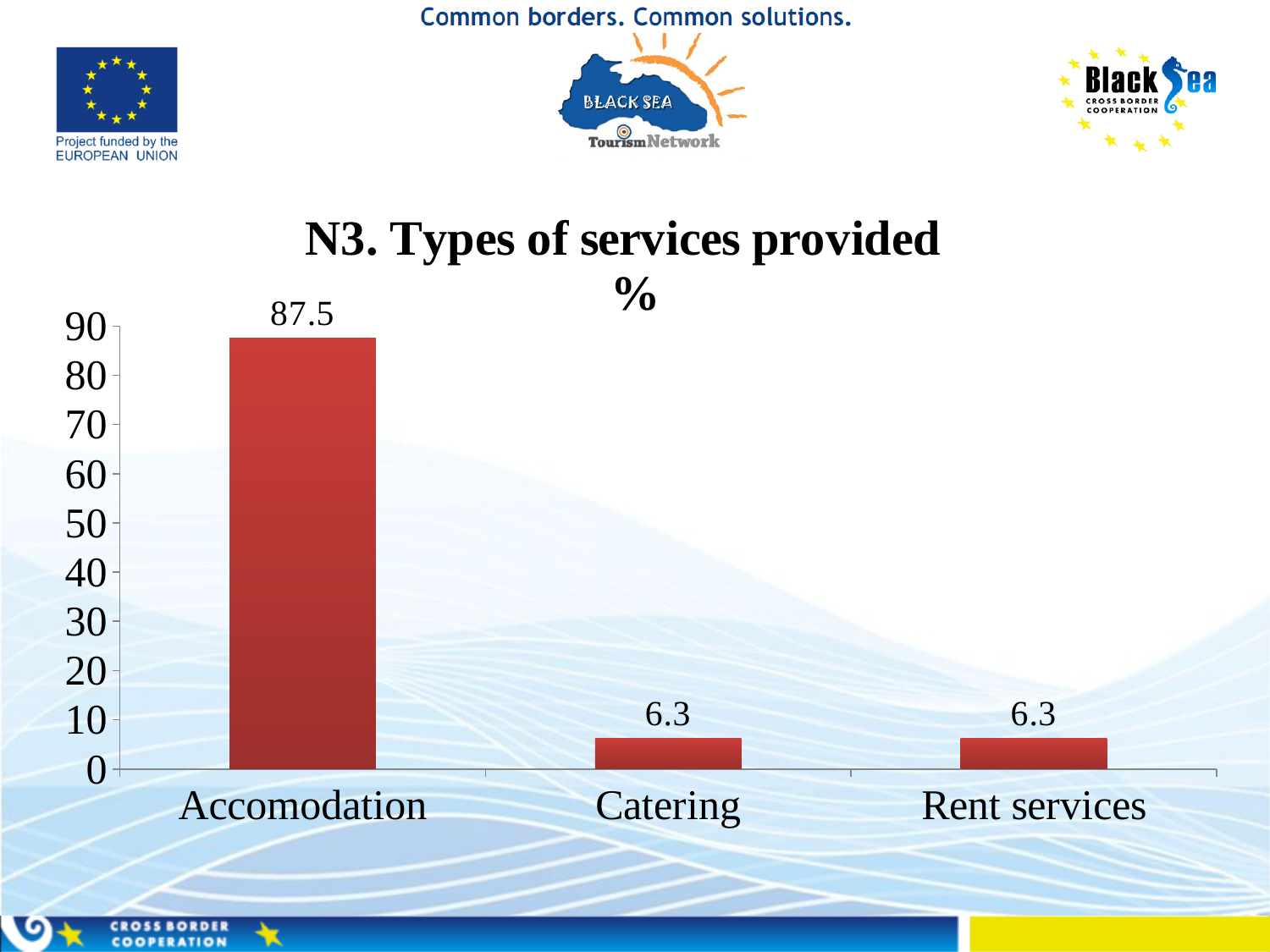
What is the value for Rent services? 6.3 What is the title of the chart? N3. Types of services provided % What is the value for Accomodation? 87.5 What kind of chart is shown on the slide? bar chart How many categories are shown on the x axis? 3 What is the difference between the values for Accomodation and Catering? 81.2 Which is larger, the value for Accomodation or the value for Rent services? Accomodation Is the value for Accomodation greater or less than 80? greater What is the value for Catering? 6.3 What colour are the bars in the chart? red Is the value for Catering greater or less than 10? less Which category has the highest value? Accomodation